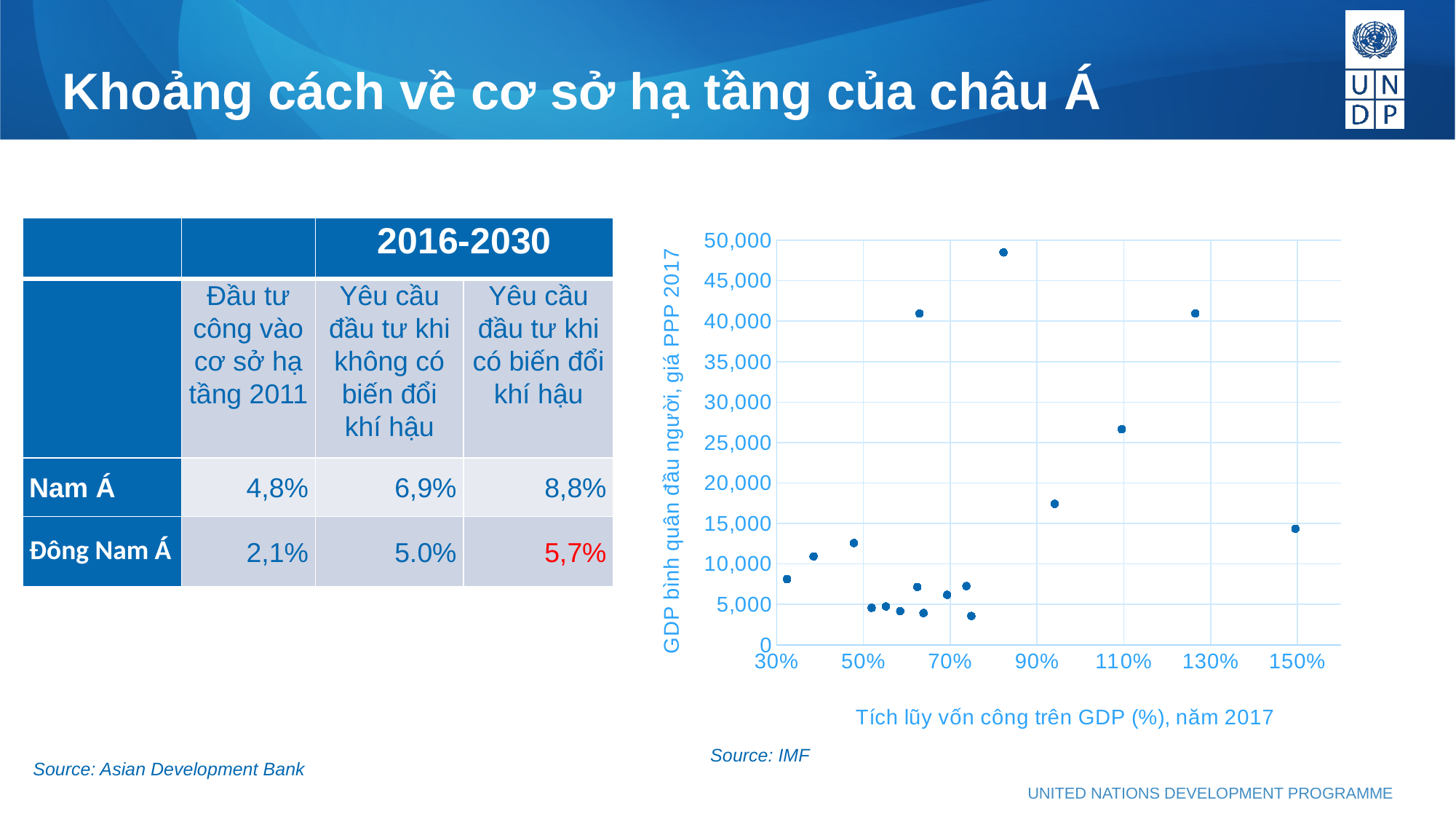
In the scatter chart, is the y value of the highest point greater or less than 45,000? greater What is the highest tick value shown on the y axis of the scatter chart? 50,000 What is the title of the x axis of the scatter chart? Tích lũy vốn công trên GDP (%), năm 2017 What kind of chart is shown on the right side of the slide? scatter chart In the scatter chart, is the y value of the point at about 110% on the x axis greater or less than 25,000? greater In the scatter chart, is the y value of the point at about 150% on the x axis greater or less than 20,000? less What is the title of the y axis of the scatter chart? GDP bình quân đầu người, giá PPP 2017